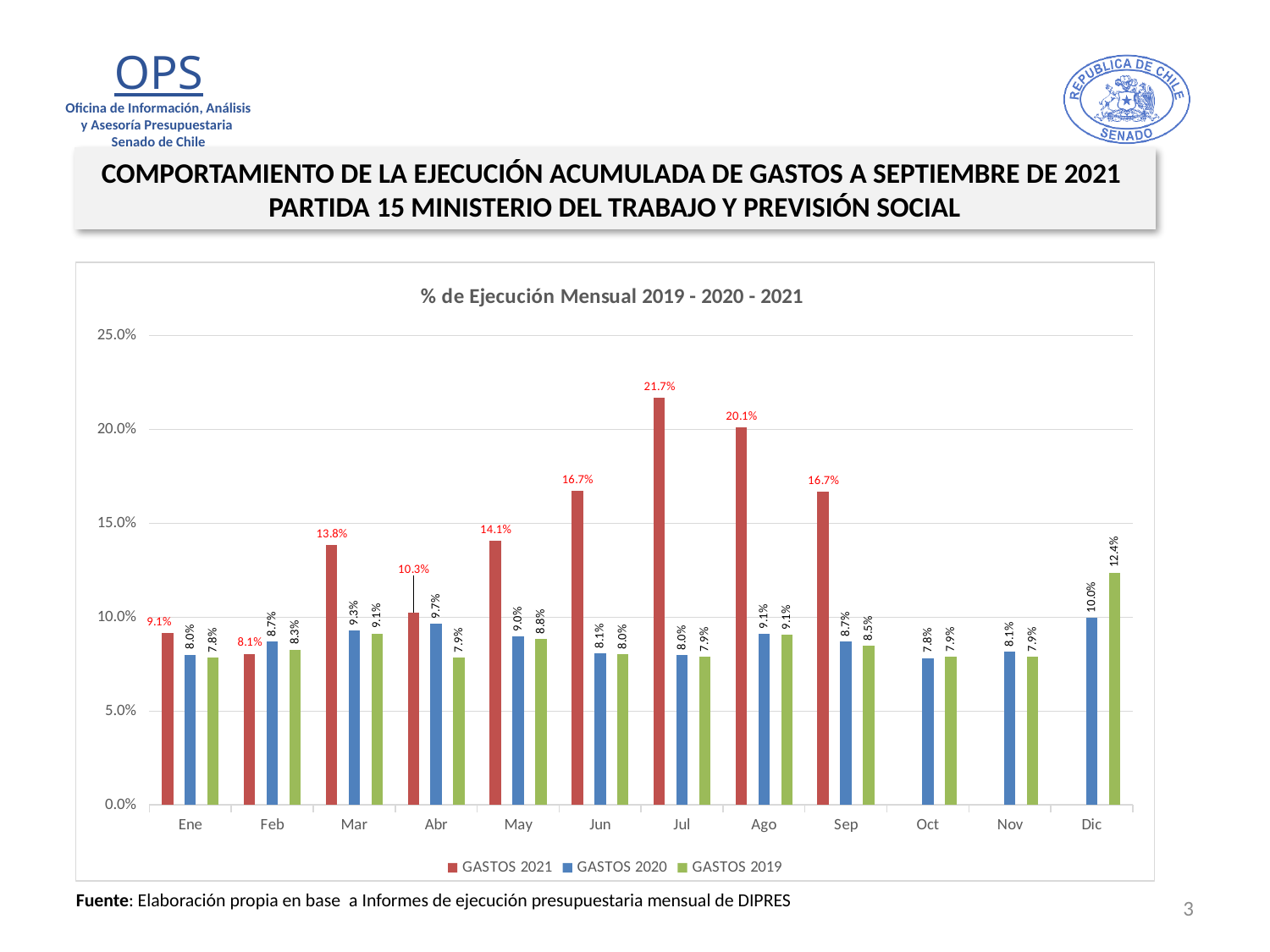
In which month is the GASTOS 2020 value lowest? Oct What is the value for GASTOS 2019 in Dic? 12.4% What is the value for GASTOS 2021 in Jul? 21.7% Is the value for GASTOS 2021 in Sep greater or less than 15.0%? greater What is the value for GASTOS 2020 in Abr? 9.7% What is the title of the chart? % de Ejecución Mensual 2019 - 2020 - 2021 In which month is the GASTOS 2021 value highest? Jul Which is larger in Feb: GASTOS 2021 or GASTOS 2020? GASTOS 2020 How many months are shown on the x axis? 12 What type of chart is shown on the slide? Bar chart What is the difference between GASTOS 2021 and GASTOS 2020 in Ago? 11.0% How many series does the legend list? 3